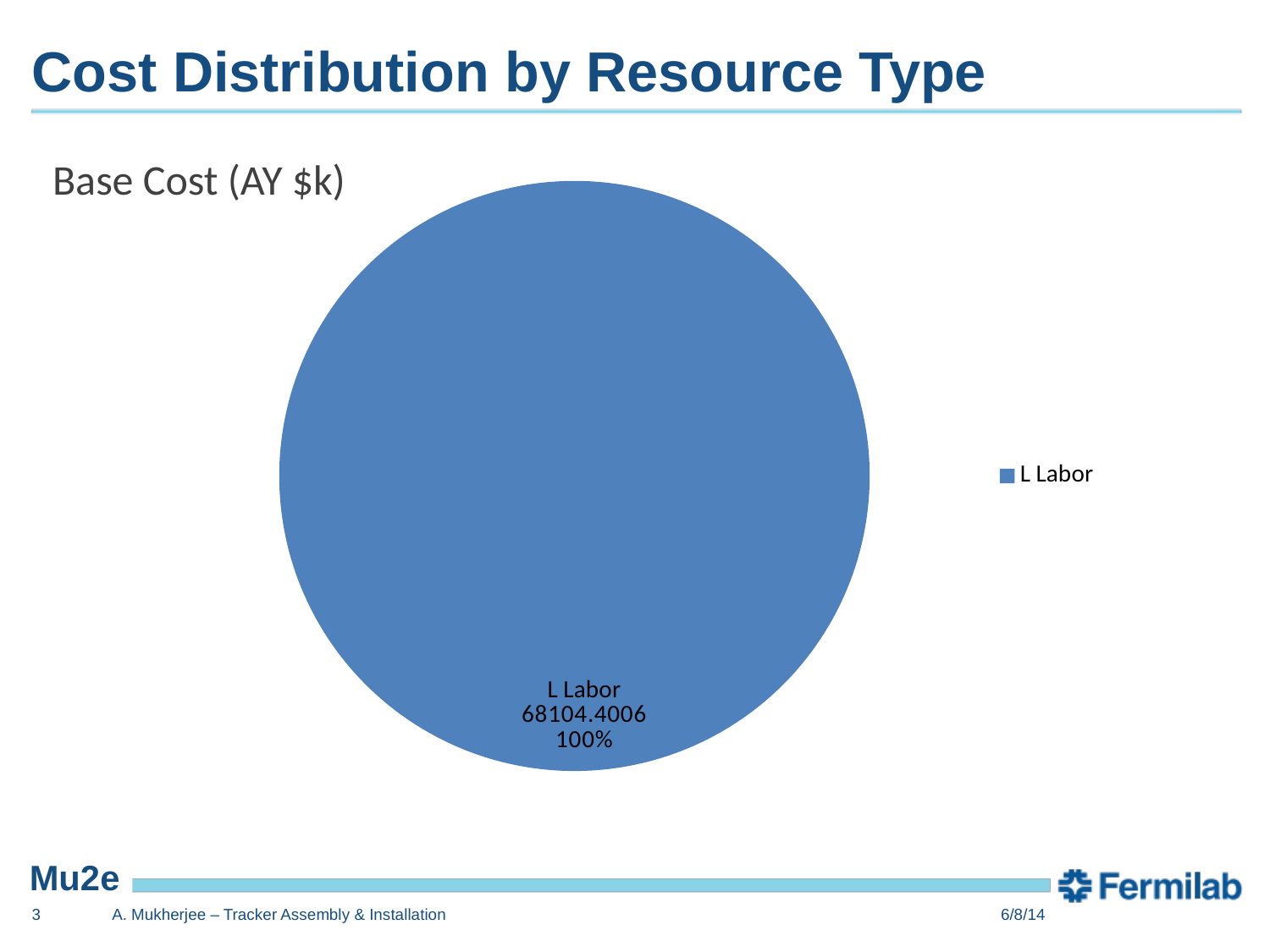
How many slices does the pie chart have? 1 Is the value for L Labor greater or less than 50000? greater What share of the pie does L Labor represent? 100% What is the title of the chart? Base Cost (AY $k) What kind of chart is shown on the slide? pie chart What is the value shown for L Labor? 68104.4006 Which category has the largest share of the pie? L Labor How many entries does the legend list? 1 What is the label of the only slice in the pie chart? L Labor